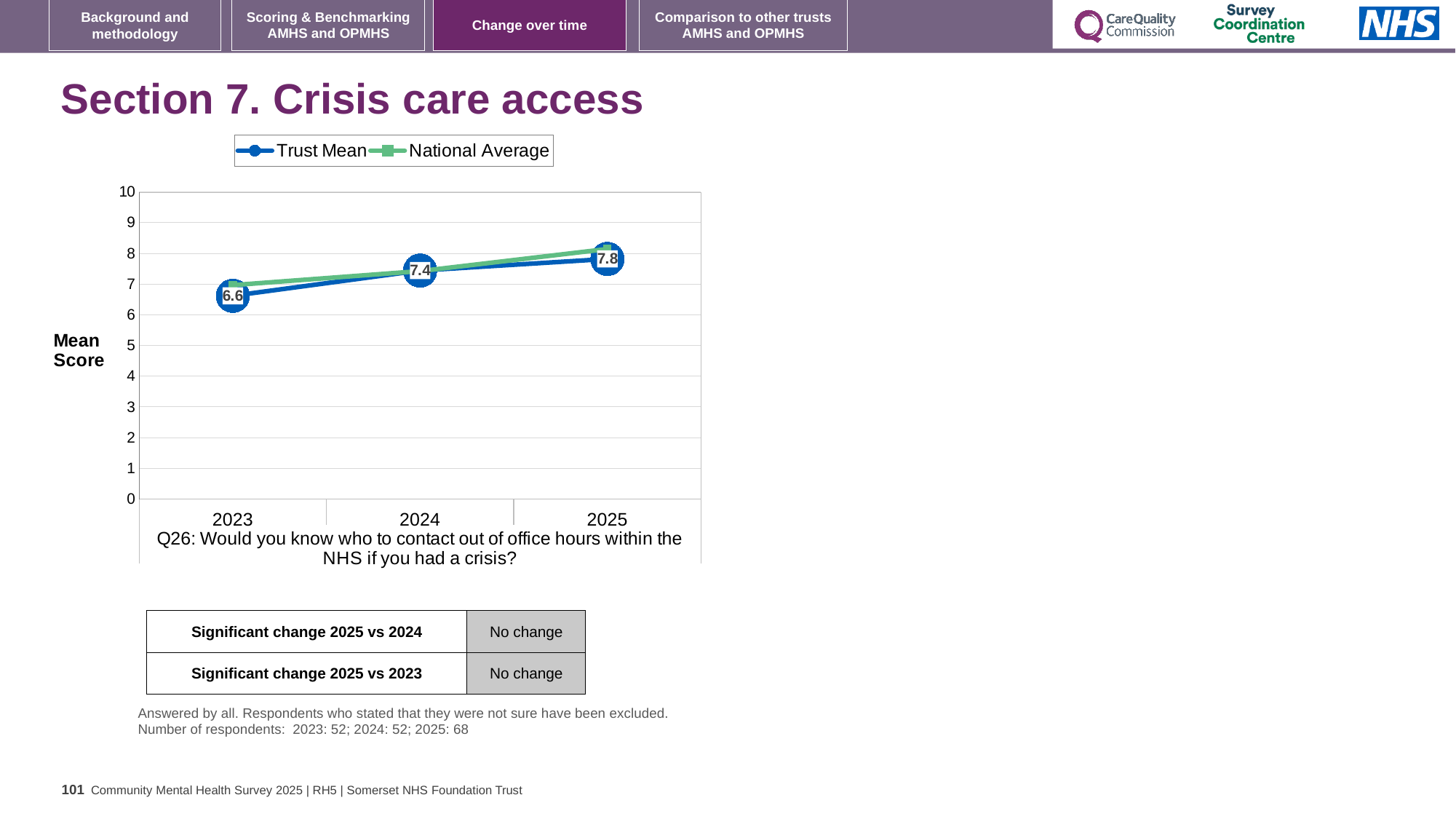
What is the Trust Mean score for 2025? 7.8 In which year is the Trust Mean lowest? 2023 Does the Trust Mean rise or fall from 2023 to 2025? Rise What is the Trust Mean score for 2024? 7.4 Is the National Average value for 2023 greater or less than 6? greater What is the Trust Mean score for 2023? 6.6 In which year is the Trust Mean highest? 2025 How many years are shown on the x axis? 3 What kind of chart is shown on the slide? Line chart How many series does the legend list? 2 What is the difference between the Trust Mean in 2025 and in 2023? 1.2 Which is larger, the Trust Mean for 2024 or for 2023? 2024